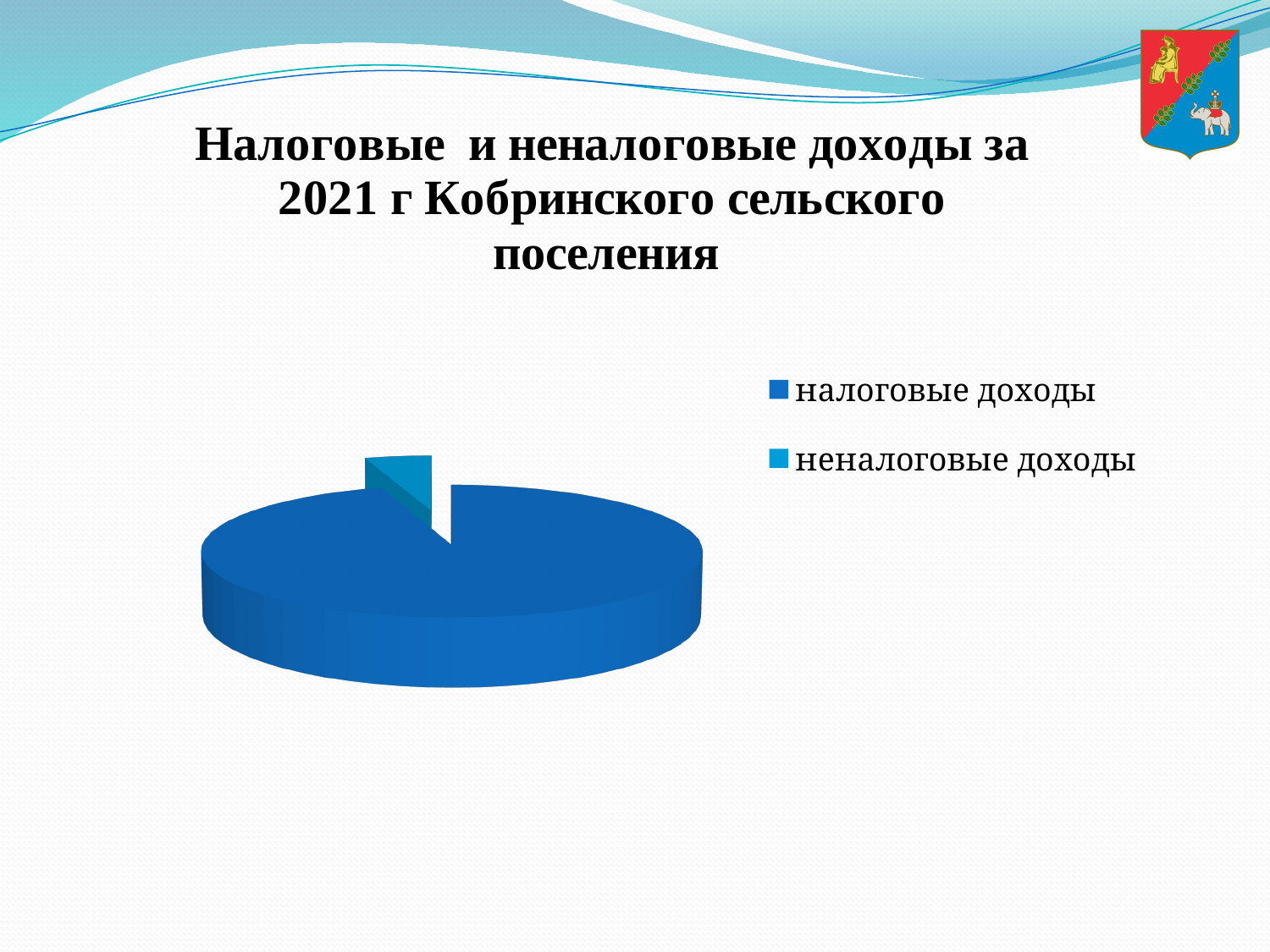
How many slices does the pie chart have? 2 Which legend entry is shown in the lighter blue colour? неналоговые доходы What kind of chart is shown on the slide? pie chart Which category has the largest slice of the pie? налоговые доходы Which category has the smallest slice of the pie? неналоговые доходы How many entries does the legend list? 2 Which is larger, the slice for налоговые доходы or the slice for неналоговые доходы? налоговые доходы What is the title of the slide's chart? Налоговые и неналоговые доходы за 2021 г Кобринского сельского поселения